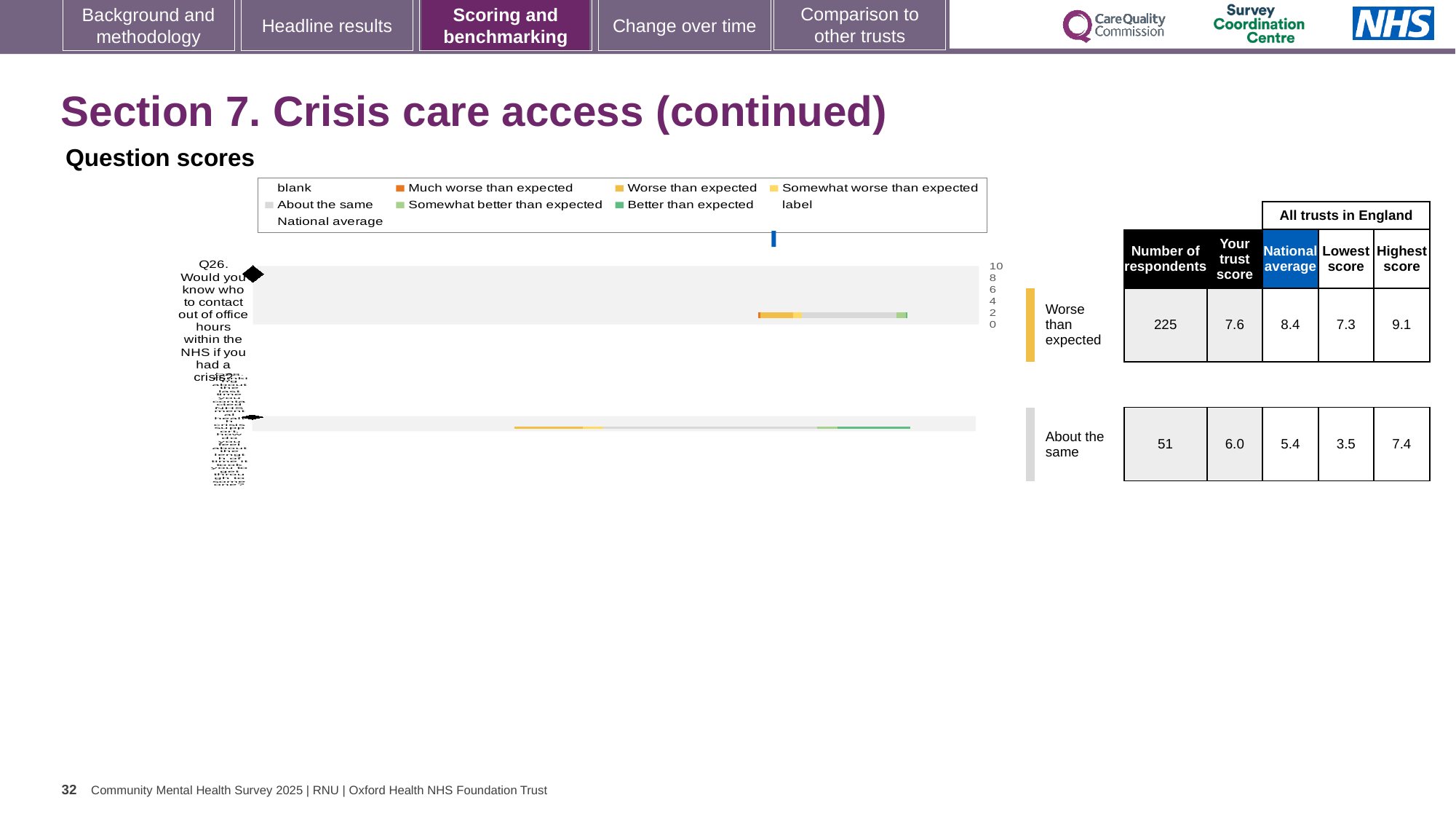
What is the 'Your trust score' for Q26 (Would you know who to contact out of office hours within the NHS if you had a crisis?)? 7.6 What is the trust score for the second question row, rated 'About the same'? 6.0 What is the national average score for Q26? 8.4 Which is larger for Q26, the trust score or the national average? national average In the legend, what colour represents 'Much worse than expected'? orange What is the lowest score among all trusts in England for Q26? 7.3 What kind of chart is shown under 'Question scores'? bar chart How many question rows are plotted in the Question scores chart? 2 What is the difference between the national average and the trust score for Q26? 0.8 What is the highest score among all trusts in England for Q26? 9.1 How many respondents answered Q26? 225 What benchmark category is Q26 rated as? Worse than expected